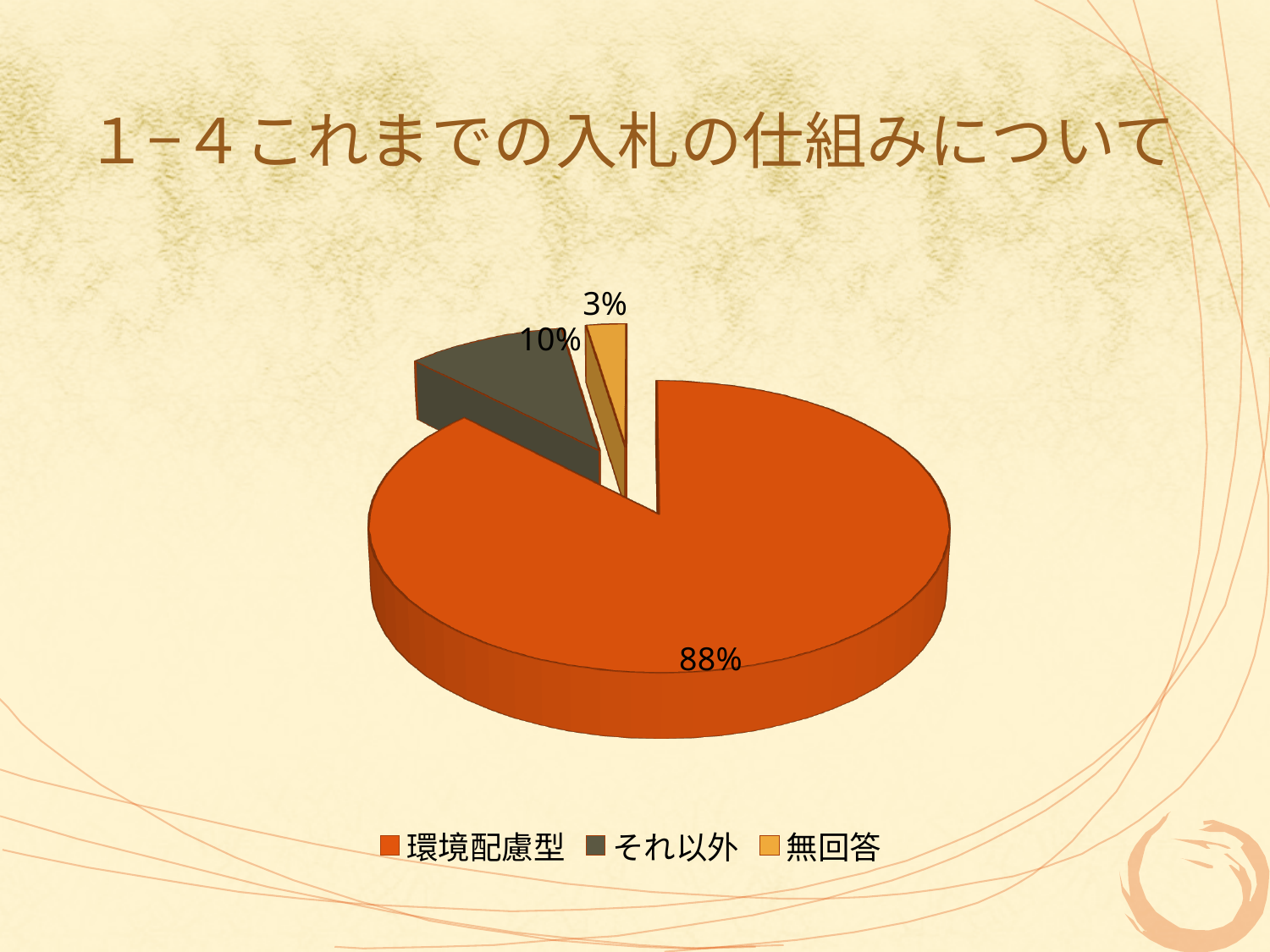
What is the title of the slide containing the chart? 1－4これまでの入札の仕組みについて How many categories does the pie chart show? 3 Which category has the smallest slice of the pie? 無回答 What is the difference in percentage points between 環境配慮型 and それ以外? 78 Which category has the largest slice of the pie? 環境配慮型 Which is larger, the share for それ以外 or the share for 無回答? それ以外 How many entries does the legend list? 3 What kind of chart is shown on the slide? pie chart What share of the pie does 無回答 have? 3% What share of the pie does 環境配慮型 have? 88% What colour is the slice for 無回答? yellow-orange What share of the pie does それ以外 have? 10%